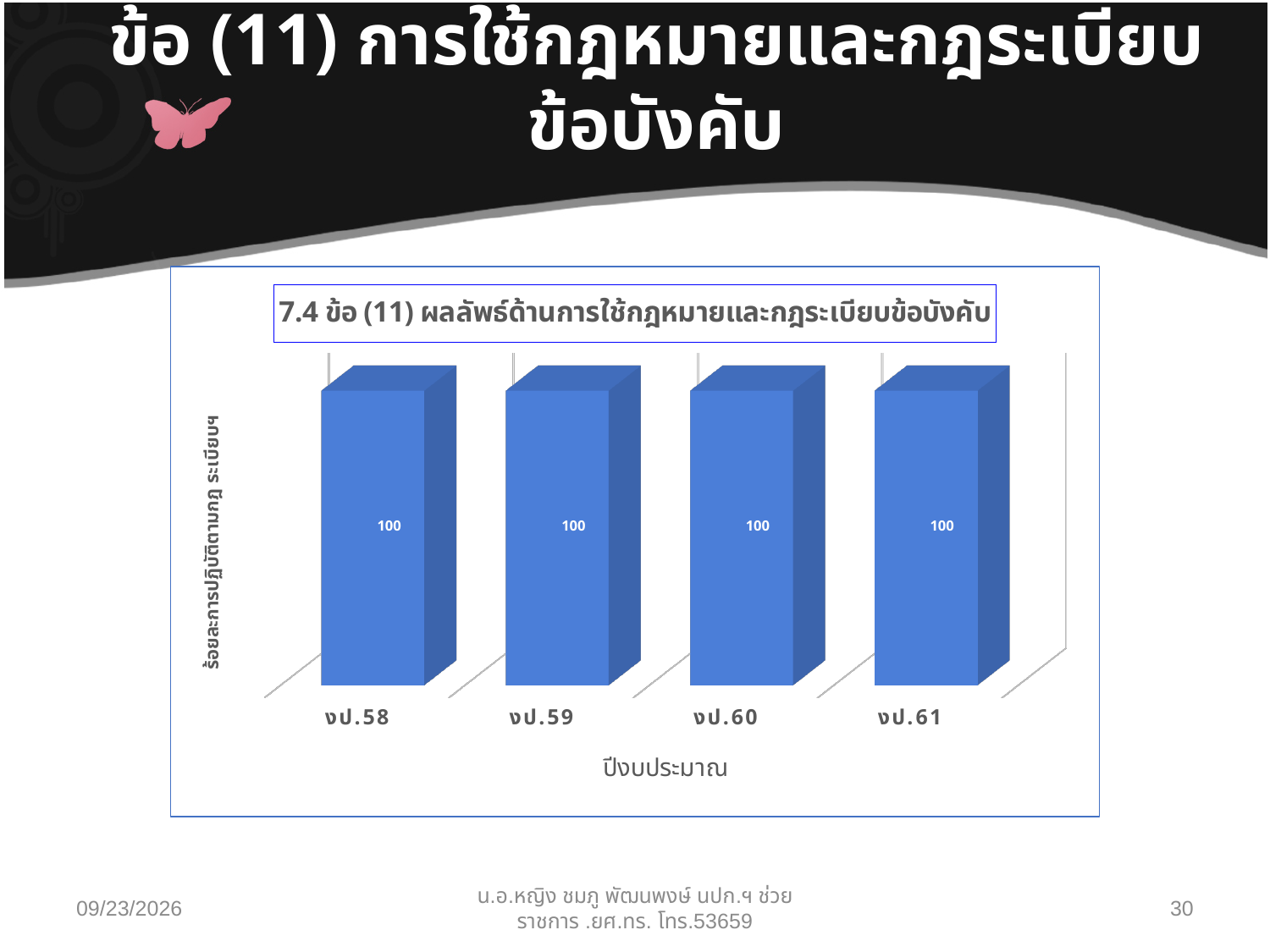
Do the values rise, fall, or stay the same from งป.58 to งป.61? Stay the same What is the value for งป.58? 100 What is the value for งป.59? 100 What is the value for งป.60? 100 What kind of chart is shown on the slide? Bar chart What is the label of the x axis? ปีงบประมาณ How many categories are shown on the x axis? 4 What is the difference between the values for งป.59 and งป.60? 0 What is the difference between the values for งป.58 and งป.61? 0 What is the value for งป.61? 100 What is the title of the chart? 7.4 ข้อ (11) ผลลัพธ์ด้านการใช้กฎหมายและกฎระเบียบข้อบังคับ